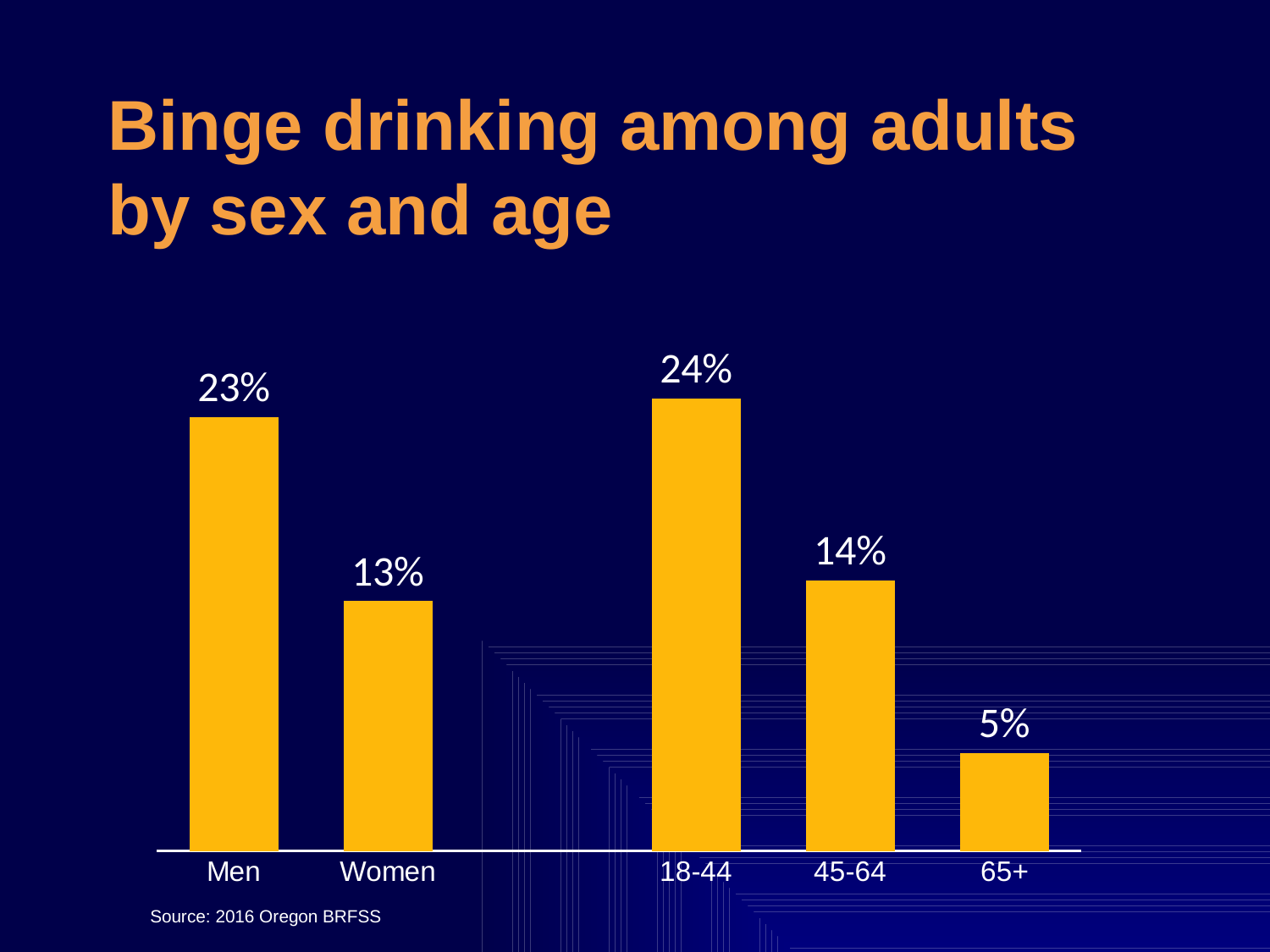
What is the difference in binge drinking percentage between the 18-44 and 45-64 age groups? 10% What is the binge drinking percentage for the 18-44 age group? 24% Do the values fall or rise across the age groups from 18-44 to 65+? Fall What is the binge drinking percentage for the 65+ age group? 5% What is the binge drinking percentage for Women? 13% What is the difference in binge drinking percentage between Men and Women? 10% Which category has the highest binge drinking percentage? 18-44 What kind of chart is shown on the slide? Bar chart Which has a higher binge drinking percentage, Women or the 45-64 age group? 45-64 What is the binge drinking percentage for Men? 23% Which category has the lowest binge drinking percentage? 65+ How many bars are shown on the chart? 5